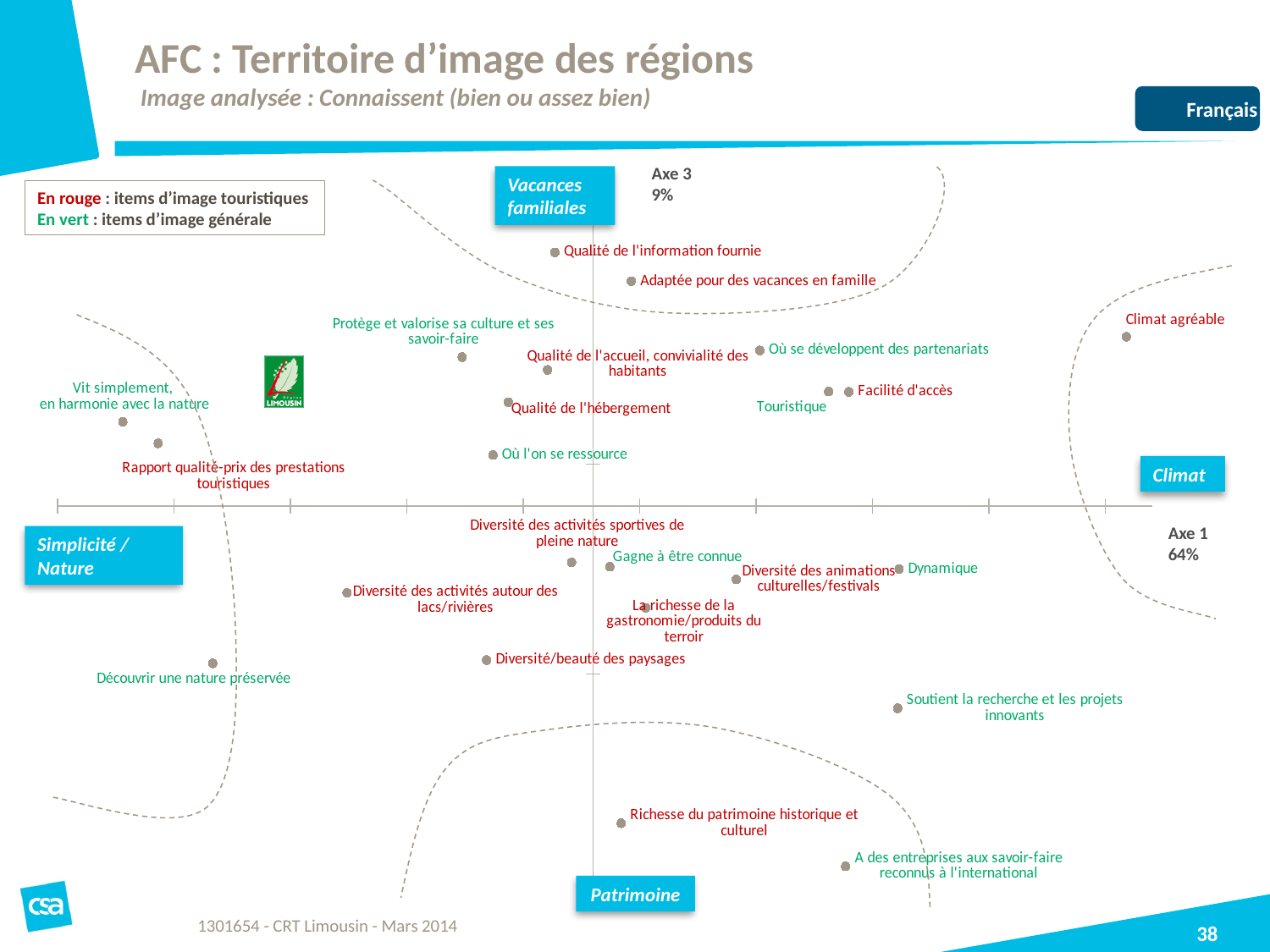
Which item is plotted furthest to the right on the chart? Climat agréable What is the label of the blue box at the bottom of the chart? Patrimoine Which is plotted further to the right: 'Climat agréable' or 'Découvrir une nature préservée'? Climat agréable Which item is plotted highest on the chart? Qualité de l'information fournie What percentage is shown for Axe 3? 9% Which item is plotted furthest to the left on the chart? Vit simplement, en harmonie avec la nature According to the legend box, what colour are the tourism image items ('items d'image touristique') shown in? Rouge (red) Which is plotted higher: 'Adaptée pour des vacances en famille' or 'Diversité/beauté des paysages'? Adaptée pour des vacances en famille What percentage is shown for Axe 1? 64% What kind of chart is shown on the slide? Scatter plot Which axis has the larger percentage, Axe 1 or Axe 3? Axe 1 Which item is plotted lowest on the chart? A des entreprises aux savoir-faire reconnus à l'international